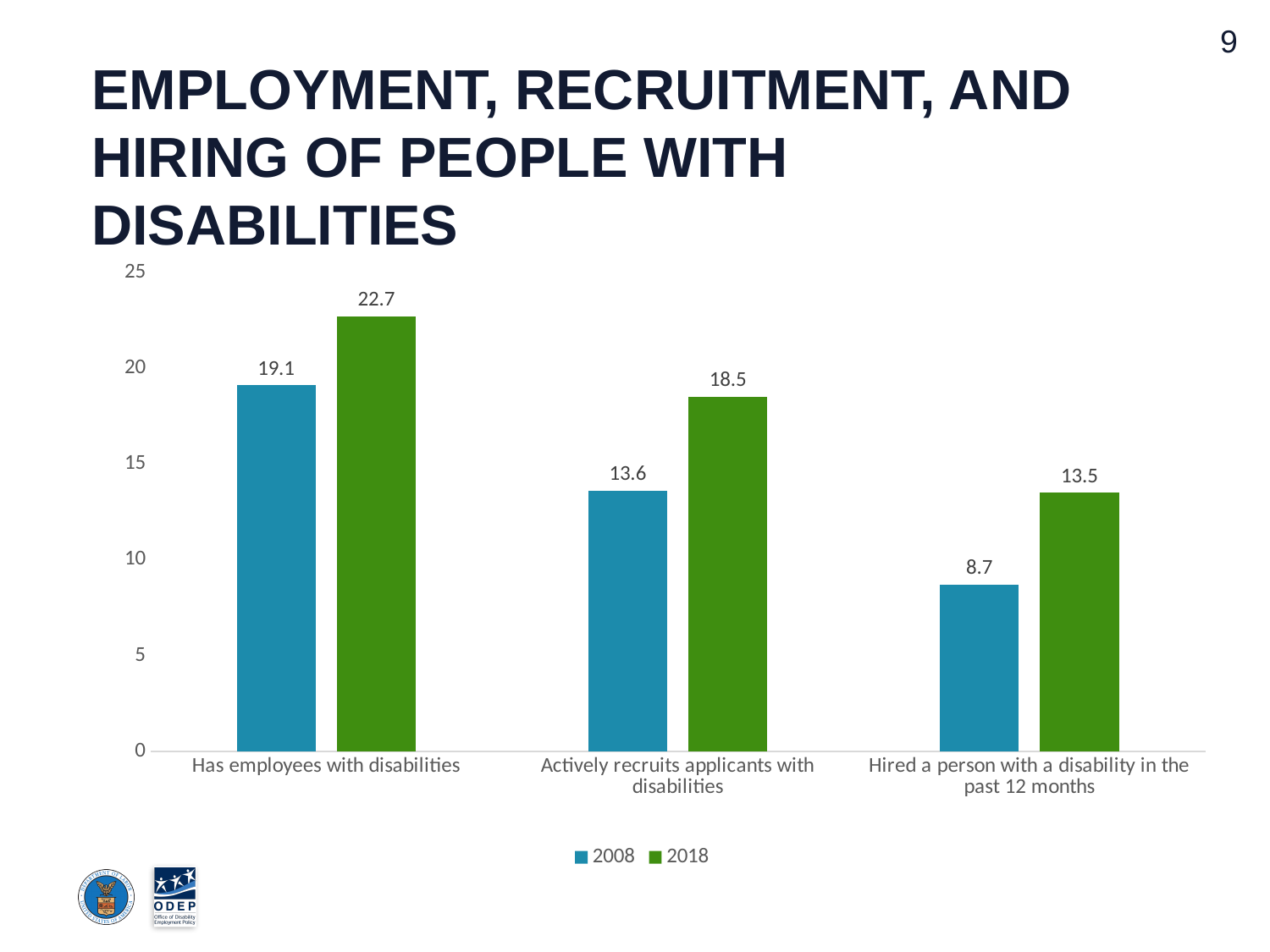
How many categories are shown on the x axis? 3 How many series does the legend list? 2 What is the 2008 value for "Hired a person with a disability in the past 12 months"? 8.7 Which is larger: the 2008 value for "Actively recruits applicants with disabilities" or the 2018 value for "Hired a person with a disability in the past 12 months"? 2008 value for Actively recruits applicants with disabilities Which category has the lowest 2008 value? Hired a person with a disability in the past 12 months What kind of chart is shown on the slide? bar chart What is the 2018 value for "Actively recruits applicants with disabilities"? 18.5 Is the 2018 value for "Has employees with disabilities" greater or less than 20? greater What is the difference between the 2018 and 2008 values for "Hired a person with a disability in the past 12 months"? 4.8 What is the difference between the 2018 and 2008 values for "Has employees with disabilities"? 3.6 Which category has the highest 2018 value? Has employees with disabilities What is the 2008 value for "Has employees with disabilities"? 19.1